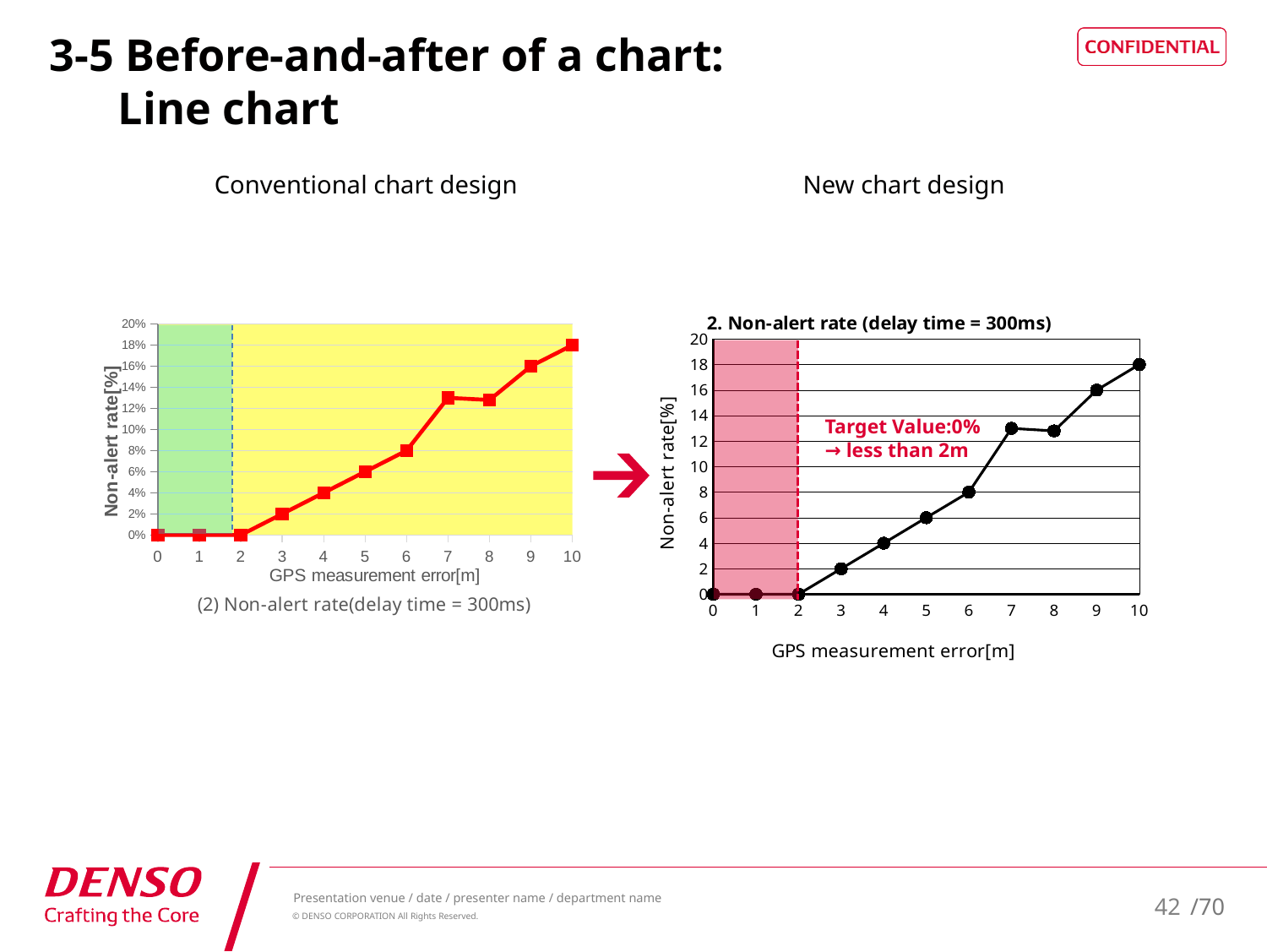
On the right chart (New chart design), does the non-alert rate generally rise or fall as GPS measurement error increases? Rise On the right chart (New chart design), what is the non-alert rate at a GPS measurement error of 4 m? 4 On the right chart (New chart design), what is the non-alert rate at a GPS measurement error of 10 m? 18 On the left chart (Conventional chart design), what is the non-alert rate at a GPS measurement error of 10 m? 18% On the left chart (Conventional chart design), what is the non-alert rate at a GPS measurement error of 6 m? 8% On the right chart (New chart design), what is the difference between the non-alert rate at 10 m and at 3 m? 16 On the right chart (New chart design), how many data points are plotted? 11 On the right chart (New chart design), at which GPS measurement error is the non-alert rate highest? 10 On the right chart (New chart design), is the non-alert rate at a GPS measurement error of 7 m greater or less than 10? greater On the left chart (Conventional chart design), which is larger: the non-alert rate at 9 m or at 5 m? 9 m What is the title of the right chart (New chart design)? 2. Non-alert rate (delay time = 300ms) What type of chart is shown on the left under 'Conventional chart design'? Line chart